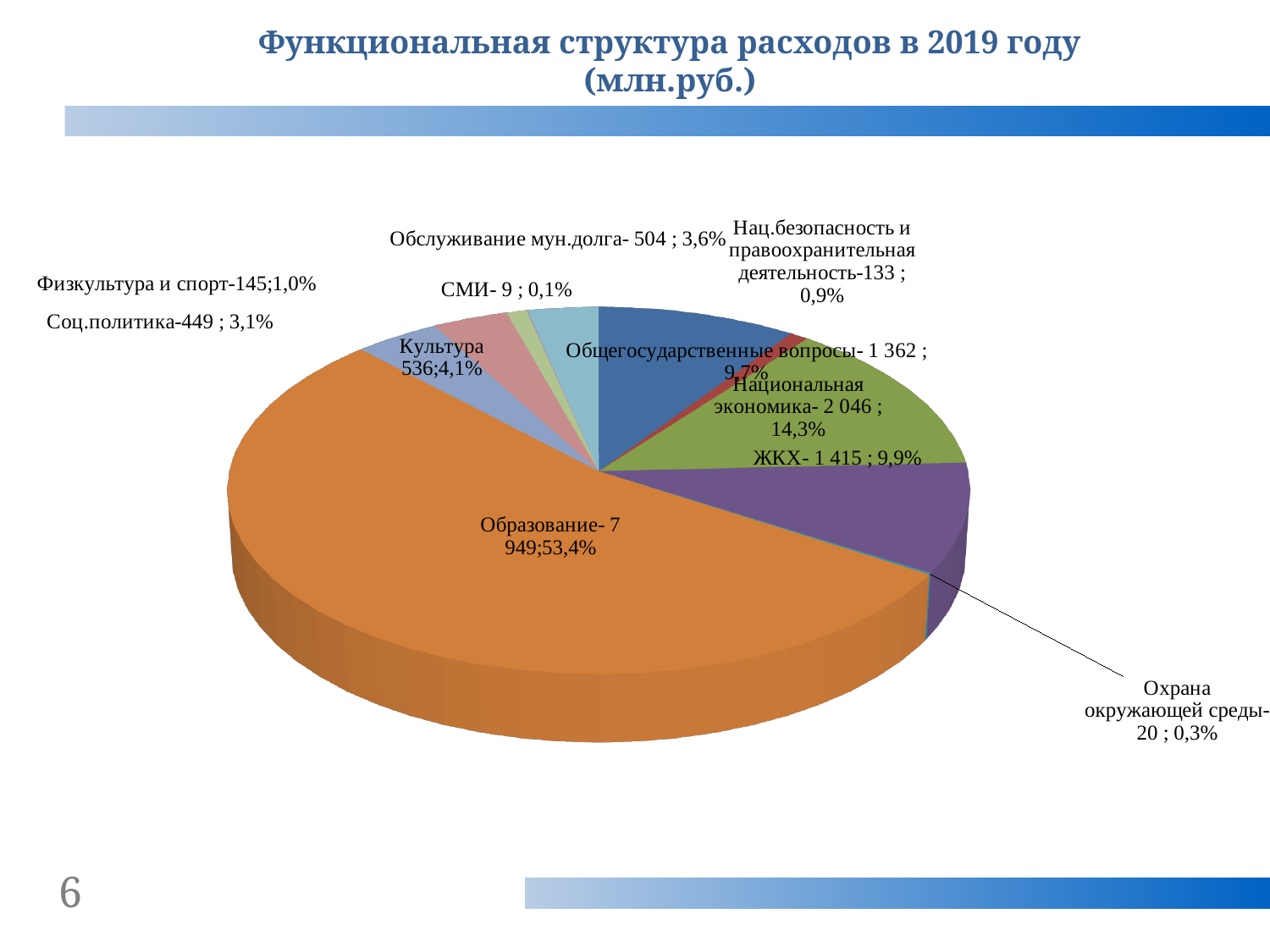
How many categories (slices) does the pie chart show? 11 Which category has the smallest share of expenditures? СМИ What is the value for Образование in млн.руб.? 7 949 What share of the pie does Образование take? 53,4% What is the value for Охрана окружающей среды? 20 Which category has the largest share of expenditures? Образование Which is larger: Общегосударственные вопросы or Культура? Общегосударственные вопросы What is the value for Национальная экономика? 2 046 What kind of chart is shown on the slide? Pie chart What is the difference between the values for Национальная экономика and ЖКХ? 631 What share of the pie does ЖКХ take? 9,9% What is the title of the chart? Функциональная структура расходов в 2019 году (млн.руб.)